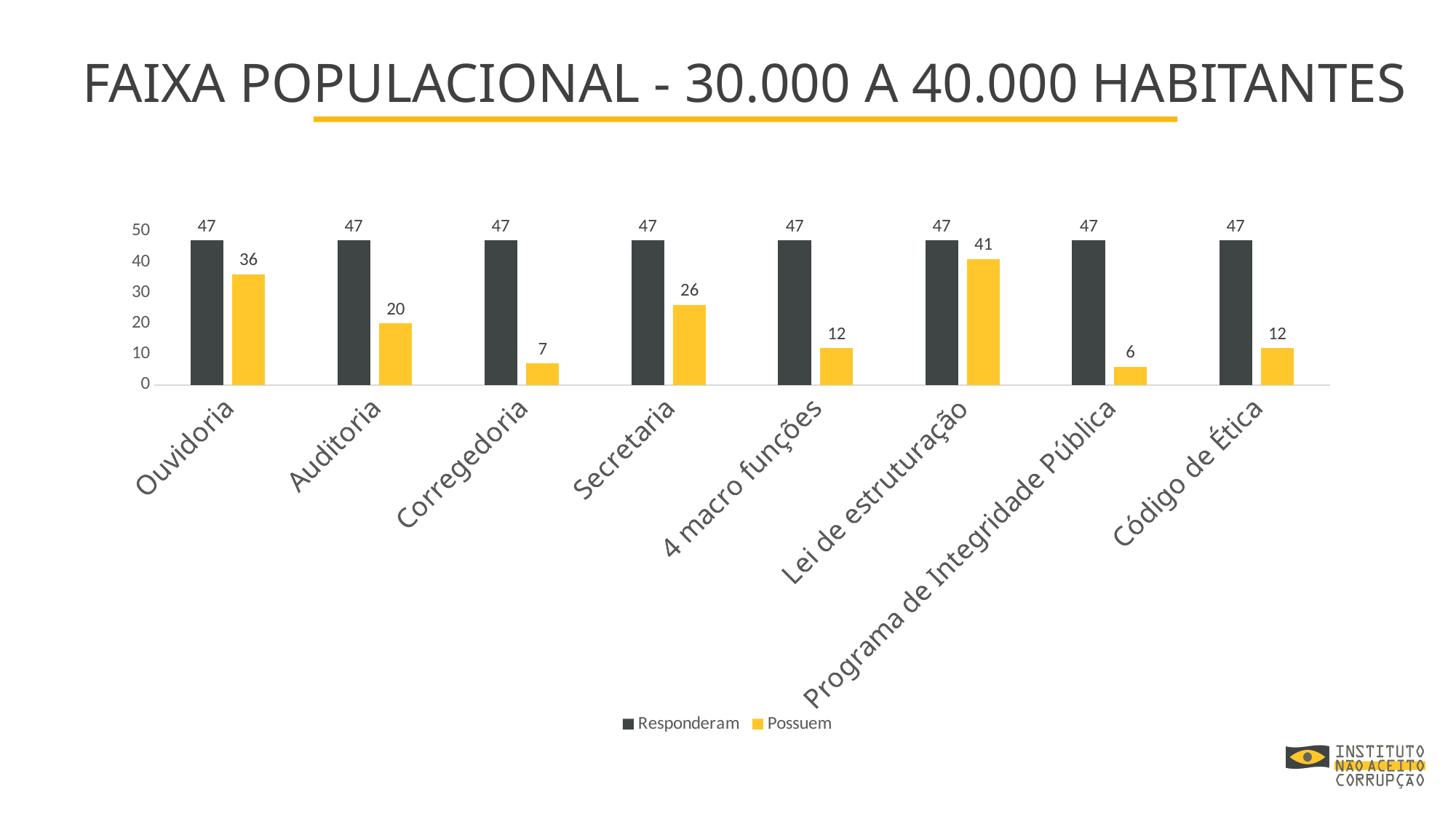
How many categories are shown on the x axis? 8 What is the 'Responderam' value for Auditoria? 47 How many series does the legend list? 2 What is the 'Possuem' value for Ouvidoria? 36 Is the 'Possuem' value for Ouvidoria greater or less than 30? greater Which category has the lowest 'Possuem' value? Programa de Integridade Pública What is the difference between 'Responderam' and 'Possuem' for Corregedoria? 40 Which category has the highest 'Possuem' value? Lei de estruturação Which has a larger 'Possuem' value, Secretaria or Auditoria? Secretaria What is the 'Possuem' value for Lei de estruturação? 41 What colour are the 'Possuem' bars? Yellow What kind of chart is shown on the slide? Bar chart